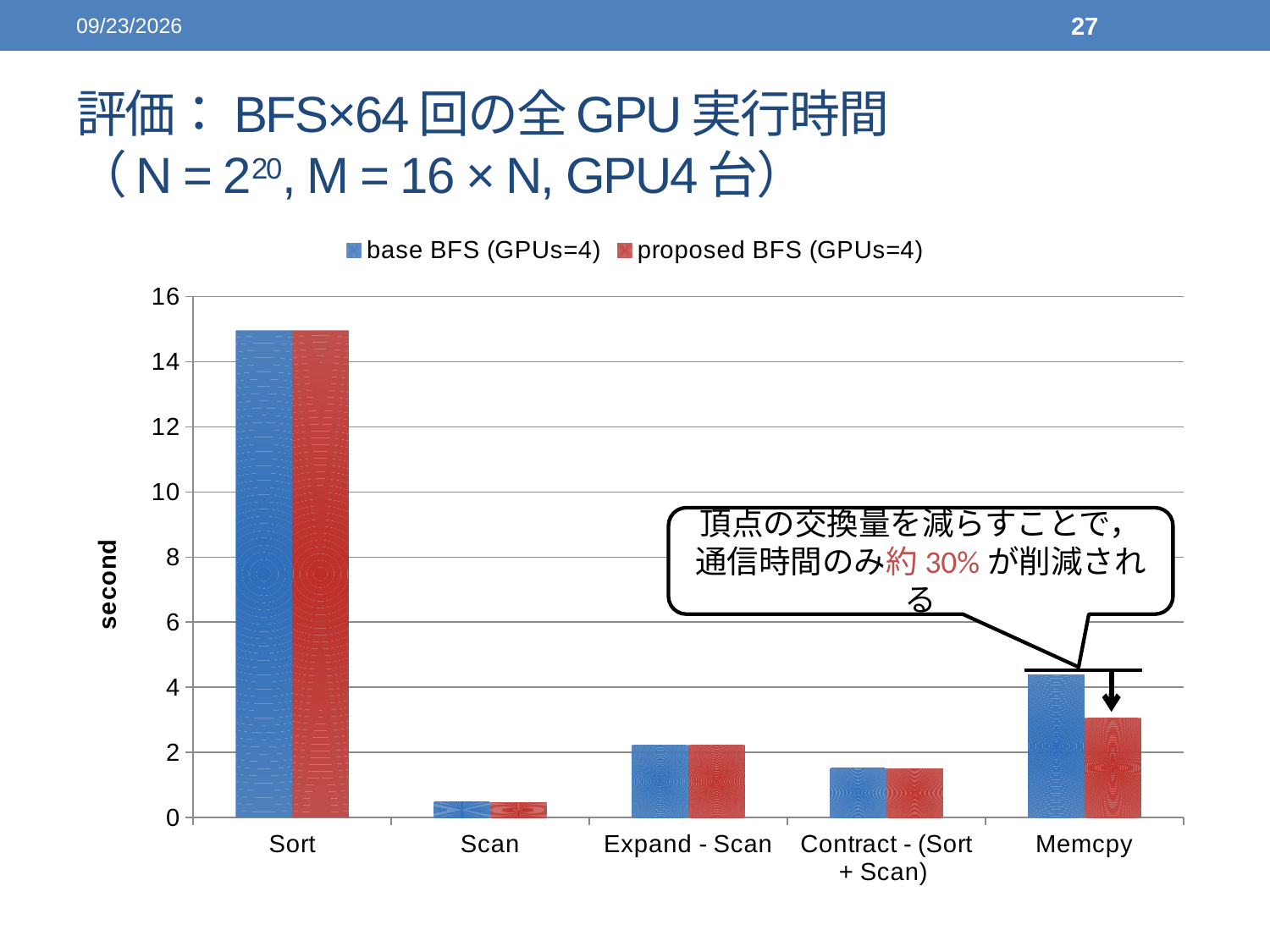
Which series is shown in red? proposed BFS (GPUs=4) Is the value for Sort in the base BFS (GPUs=4) series greater or less than 14? greater How many categories are shown on the x axis? 5 Which category has the highest value for base BFS (GPUs=4)? Sort Is the value for Scan in the base BFS (GPUs=4) series greater or less than 2? less Is the value for Memcpy in the proposed BFS (GPUs=4) series greater or less than 4? less Which category has the lowest value for proposed BFS (GPUs=4)? Scan What kind of chart is shown on the slide? bar chart How many series does the legend list? 2 For Memcpy, which series has the larger value, base BFS (GPUs=4) or proposed BFS (GPUs=4)? base BFS (GPUs=4) What is the label of the y axis? second